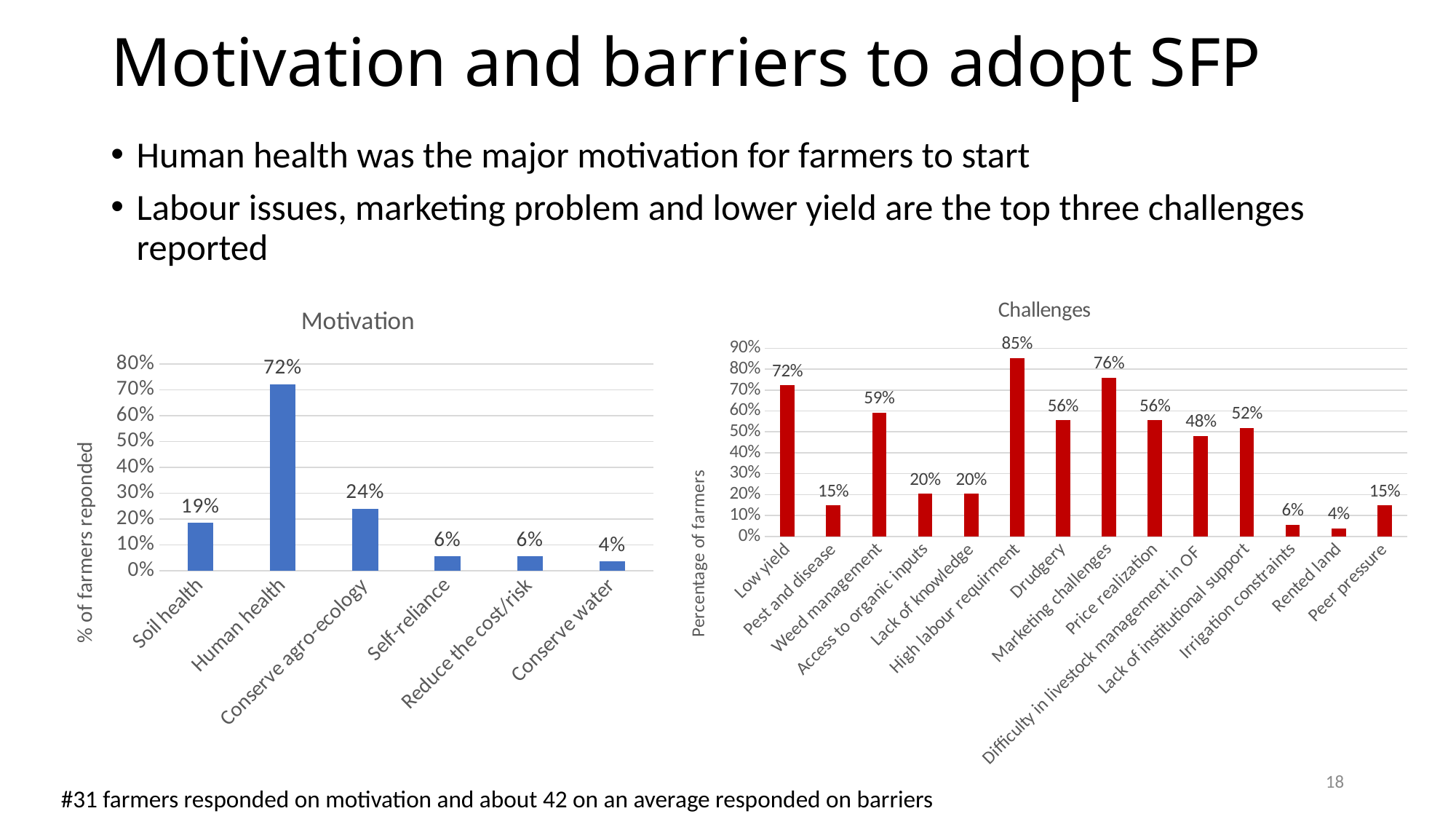
In the Challenges chart, what is the difference between High labour requirment and Drudgery? 29% In the Challenges chart, which is larger, Marketing challenges or Low yield? Marketing challenges In the Challenges chart, which category has the highest value? High labour requirment In the Motivation chart, what is the value for Conserve agro-ecology? 24% In the Motivation chart, which category has the lowest value? Conserve water In the Challenges chart, what is the value for Weed management? 59% What type of chart is the Challenges chart? Bar chart In the Challenges chart, how many categories are shown? 14 In the Motivation chart, how many categories are shown? 6 In the Motivation chart, what is the difference between Human health and Soil health? 53% In the Motivation chart, what is the value for Human health? 72% In the Challenges chart, which category has the lowest value? Rented land